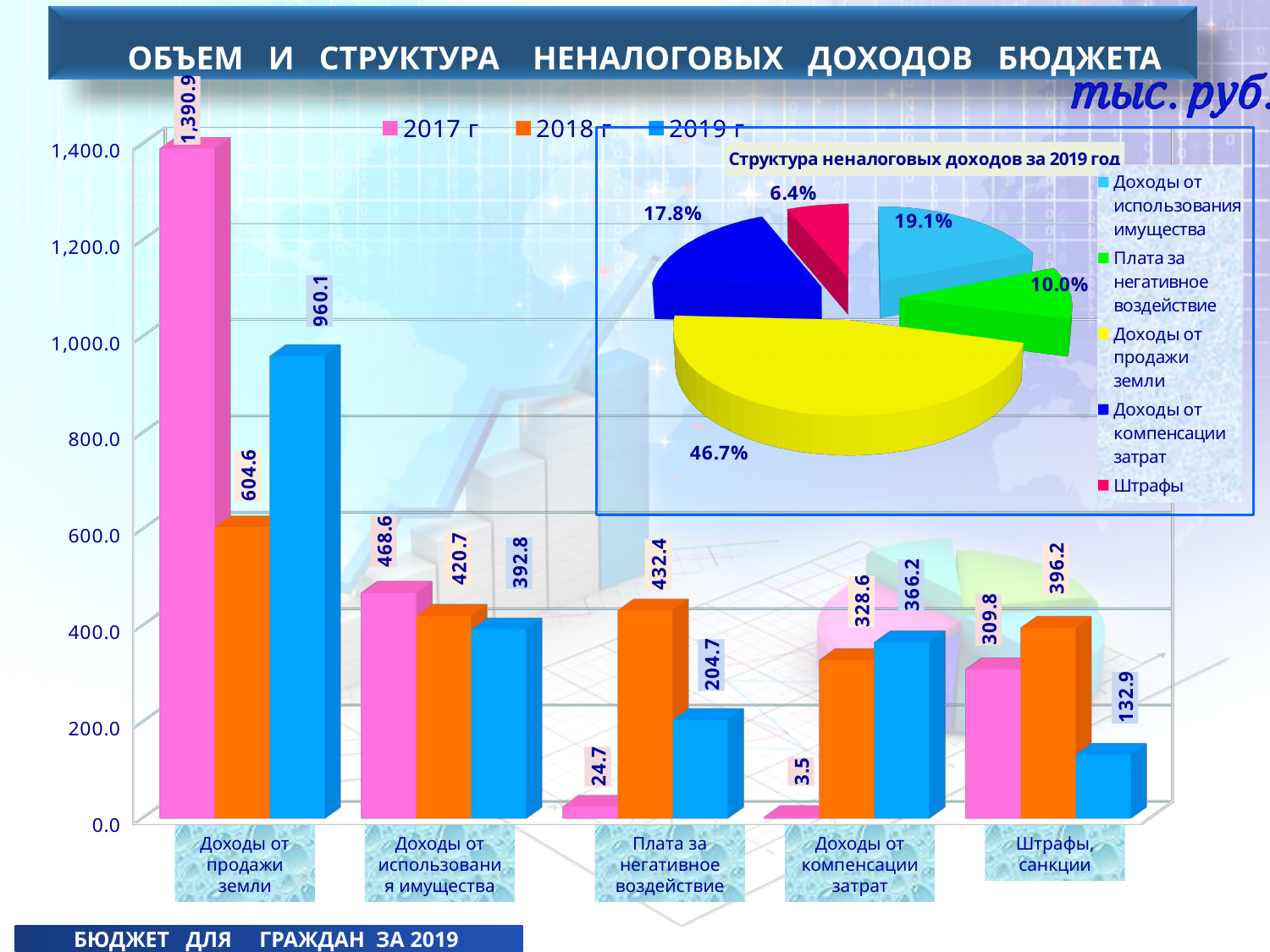
In the bar chart, which is larger for Доходы от компенсации затрат: the 2018 г value or the 2019 г value? 2019 г In the bar chart, which category has the highest value for 2019 г? Доходы от продажи земли What type of chart is the chart in the top-right inset titled Структура неналоговых доходов за 2019 год? pie chart In the pie chart Структура неналоговых доходов за 2019 год, which slice is the smallest? Штрафы In the pie chart Структура неналоговых доходов за 2019 год, what share does Доходы от продажи земли have? 46.7% In the bar chart, what is the value for Штрафы, санкции in 2018 г? 396.2 In the bar chart, what is the value for Доходы от продажи земли in 2017 г? 1,390.9 In the bar chart, what is the difference between the 2019 г and 2018 г values for Доходы от продажи земли? 355.5 In the bar chart, how many series does the legend list? 3 In the bar chart, which category has the lowest value for 2017 г? Доходы от компенсации затрат In the bar chart, what is the value for Плата за негативное воздействие in 2019 г? 204.7 In the bar chart, how many categories are shown on the x axis? 5